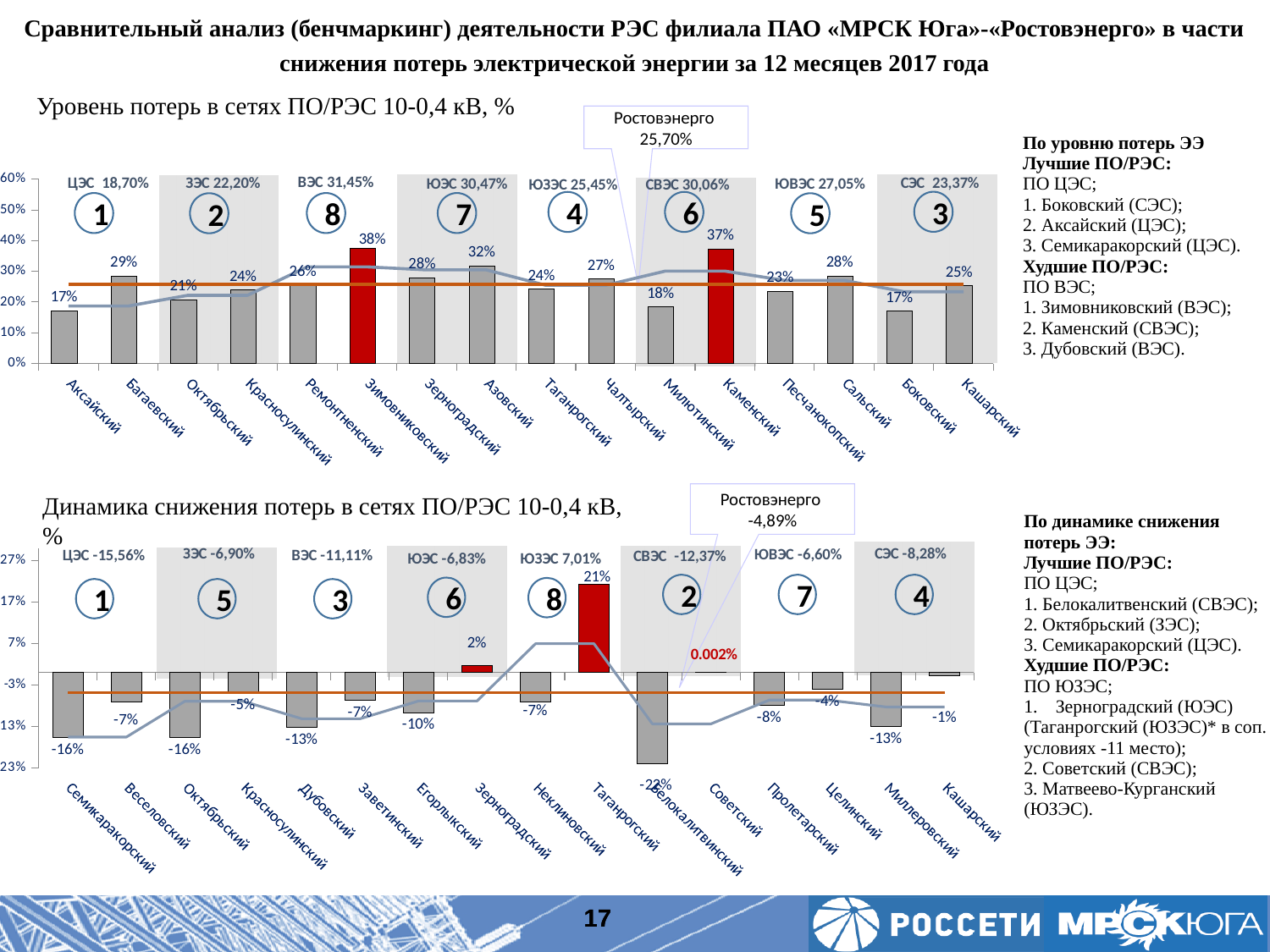
What kind of chart is the bottom chart (Динамика снижения потерь в сетях ПО/РЭС 10-0,4 кВ)? Combination bar and line chart In the bottom chart (Динамика снижения потерь в сетях ПО/РЭС 10-0,4 кВ), what is the value for Таганрогский? 21% In the top chart (Уровень потерь в сетях ПО/РЭС 10-0,4 кВ), which category has the highest value? Зимовниковский In the bottom chart (Динамика снижения потерь в сетях ПО/РЭС 10-0,4 кВ), which category has the lowest value? Белокалитвинский In the top chart (Уровень потерь в сетях ПО/РЭС 10-0,4 кВ), what is the value for Зимовниковский? 38% In the bottom chart (Динамика снижения потерь в сетях ПО/РЭС 10-0,4 кВ), what is the value for Советский? 0.002% In the bottom chart (Динамика снижения потерь в сетях ПО/РЭС 10-0,4 кВ), what is the difference between the values for Зерноградский and Егорлыкский? 12% In the top chart (Уровень потерь в сетях ПО/РЭС 10-0,4 кВ), what value is shown for Ростовэнерго? 25,70% In the top chart (Уровень потерь в сетях ПО/РЭС 10-0,4 кВ), what is the value for Азовский? 32% In the top chart (Уровень потерь в сетях ПО/РЭС 10-0,4 кВ), which is larger, the value for Багаевский or the value for Октябрьский? Багаевский In the top chart (Уровень потерь в сетях ПО/РЭС 10-0,4 кВ), how many categories are shown on the x axis? 16 In the top chart (Уровень потерь в сетях ПО/РЭС 10-0,4 кВ), what is the difference between the values for Каменский and Милютинский? 19%